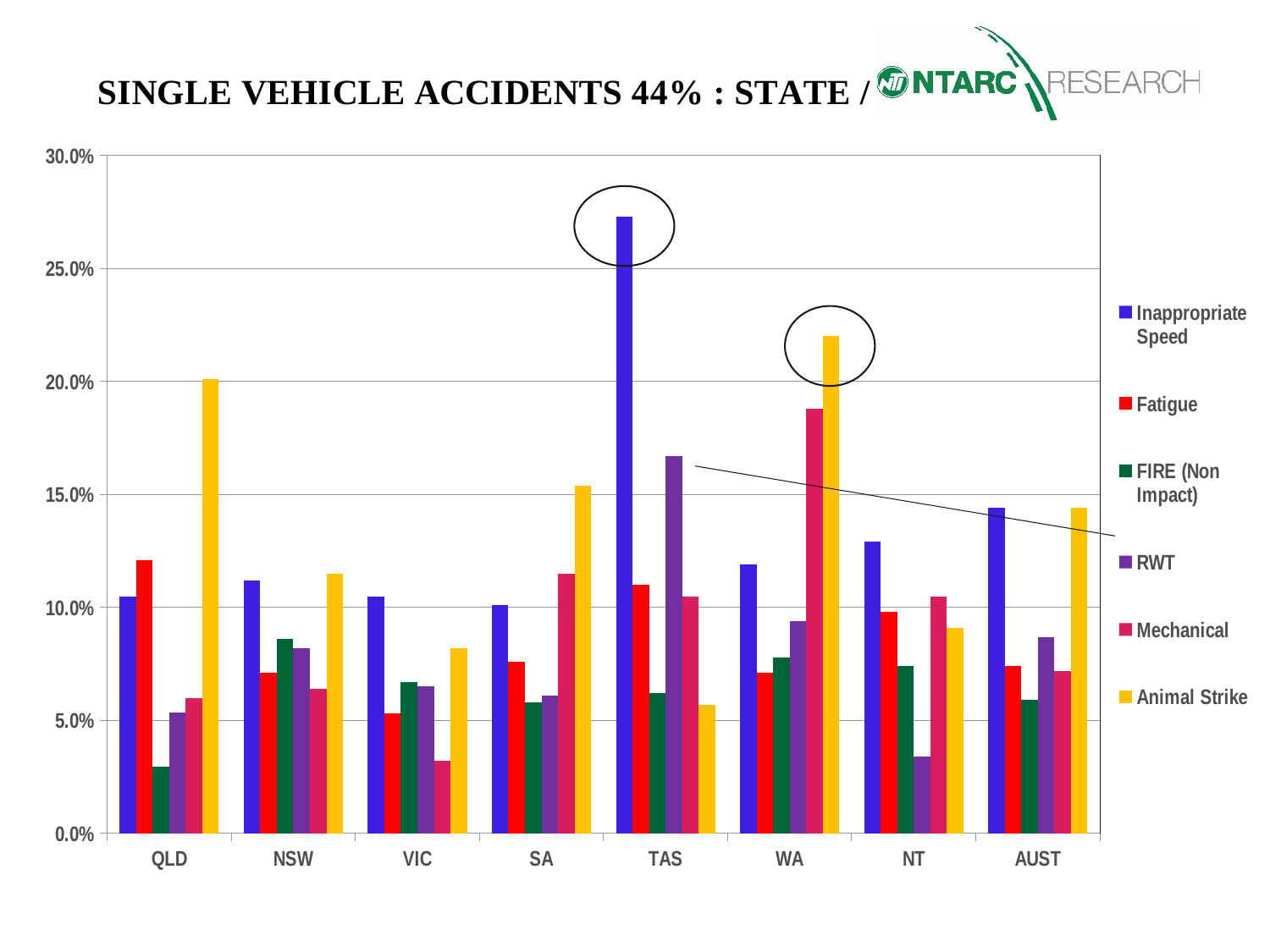
Which series is shown in yellow in the legend? Animal Strike Which state has the highest value for Mechanical? WA Is the value for FIRE (Non Impact) in QLD greater or less than 5%? less Which state has the highest value for Inappropriate Speed? TAS Is the value for Inappropriate Speed in TAS greater or less than 25%? greater Which is larger in SA: Animal Strike or Inappropriate Speed? Animal Strike Is the value for Animal Strike in QLD greater or less than 15%? greater Which state has the lowest value for Animal Strike? TAS How many states/regions are shown along the x axis? 8 Which state has the highest value for Animal Strike? WA How many series does the legend list? 6 What kind of chart is shown on the slide? bar chart